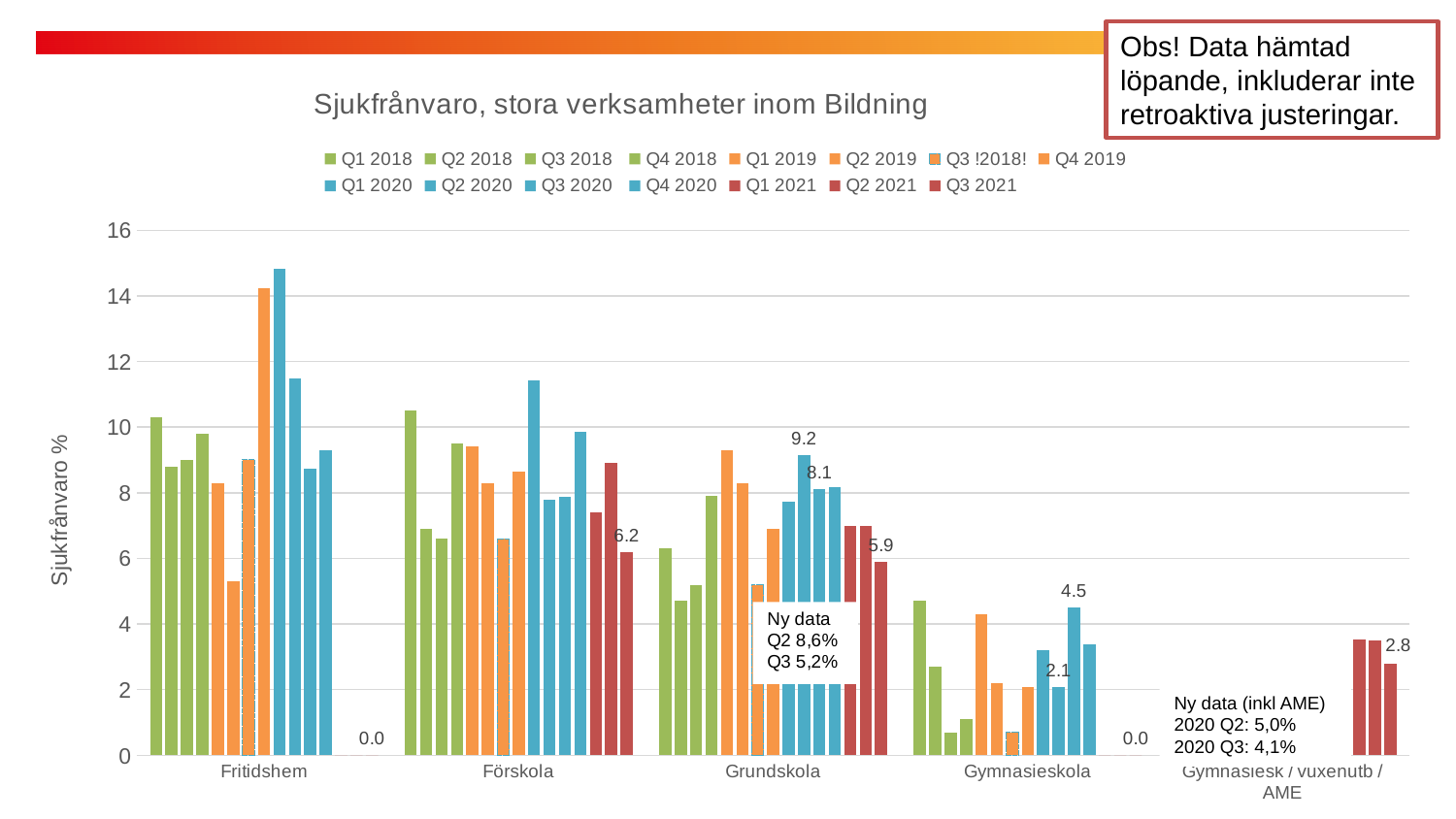
What type of chart is shown on the slide? bar chart What is the label on the y axis of the chart? Sjukfrånvaro % Which category contains the tallest bar in the chart? Fritidshem How many series does the chart legend list? 15 Which has the higher Q3 2021 value, Förskola or Grundskola? Förskola Is the Q1 2020 value for Fritidshem greater or less than 14? greater What is the Q3 2021 value for Förskola? 6.2 What is the title of the chart? Sjukfrånvaro, stora verksamheter inom Bildning What is the Q3 2021 value for Grundskola? 5.9 What is the difference between the Q3 2021 values for Förskola and Grundskola? 0.3 How many categories are shown along the x axis of the chart? 5 What is the Q3 2021 value for Gymnasiesk / vuxenutb / AME? 2.8